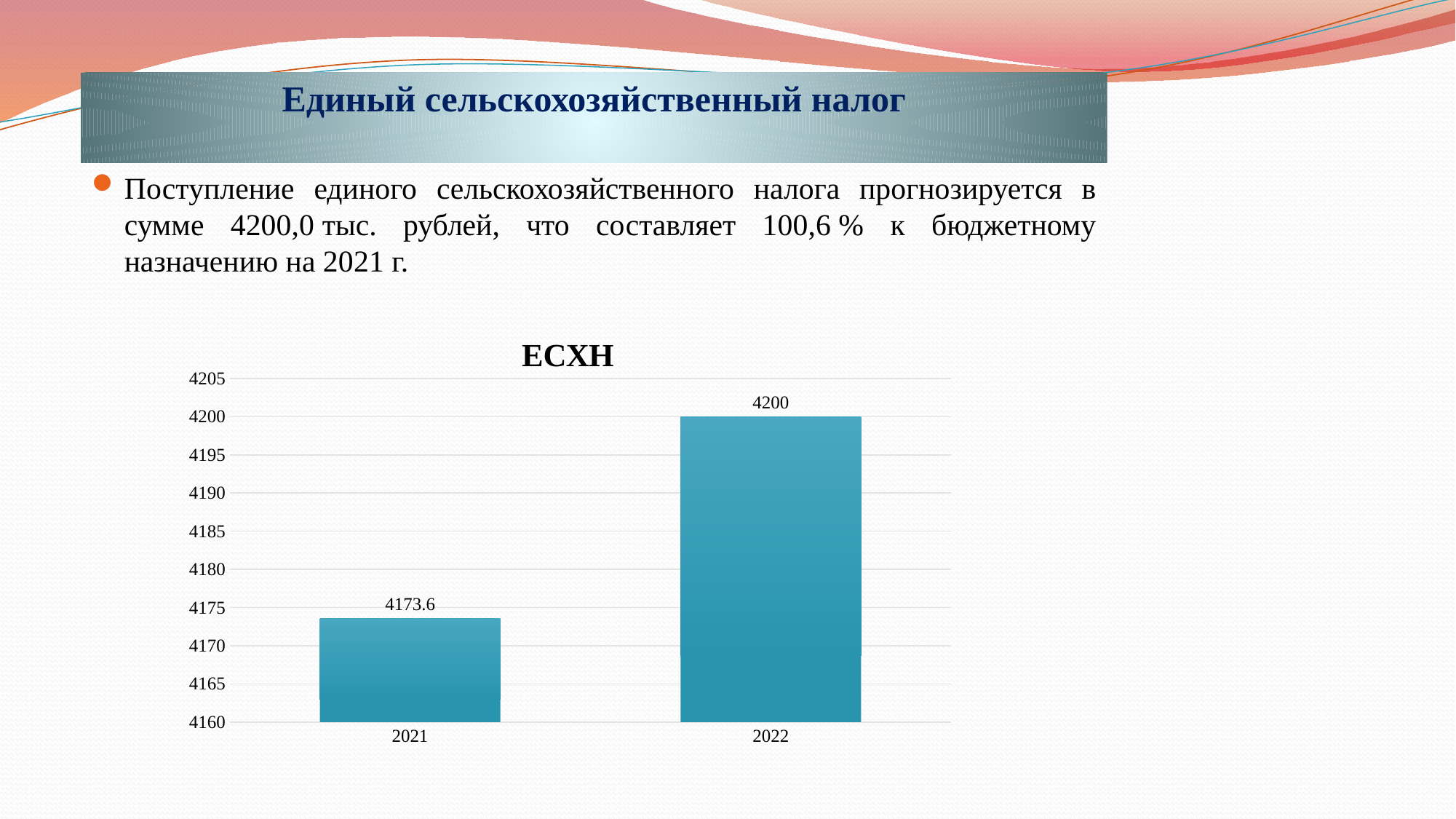
Is the value for 2022 greater or less than 4190 in the ЕСХН chart? greater What kind of chart is shown on the slide? bar chart Is the value for 2021 greater or less than 4180 in the ЕСХН chart? less Is the value for 2022 larger or smaller than the value for 2021 in the ЕСХН chart? larger What is the difference between the 2022 and 2021 values in the ЕСХН chart? 26.4 What is the title of the chart on the slide? ЕСХН What is the value for 2022 in the ЕСХН chart? 4200 What is the value for 2021 in the ЕСХН chart? 4173.6 Which year has the higher value in the ЕСХН chart? 2022 How many bars are shown in the ЕСХН chart? 2 Which year has the lower value in the ЕСХН chart? 2021 Do the values rise or fall from 2021 to 2022 in the ЕСХН chart? rise